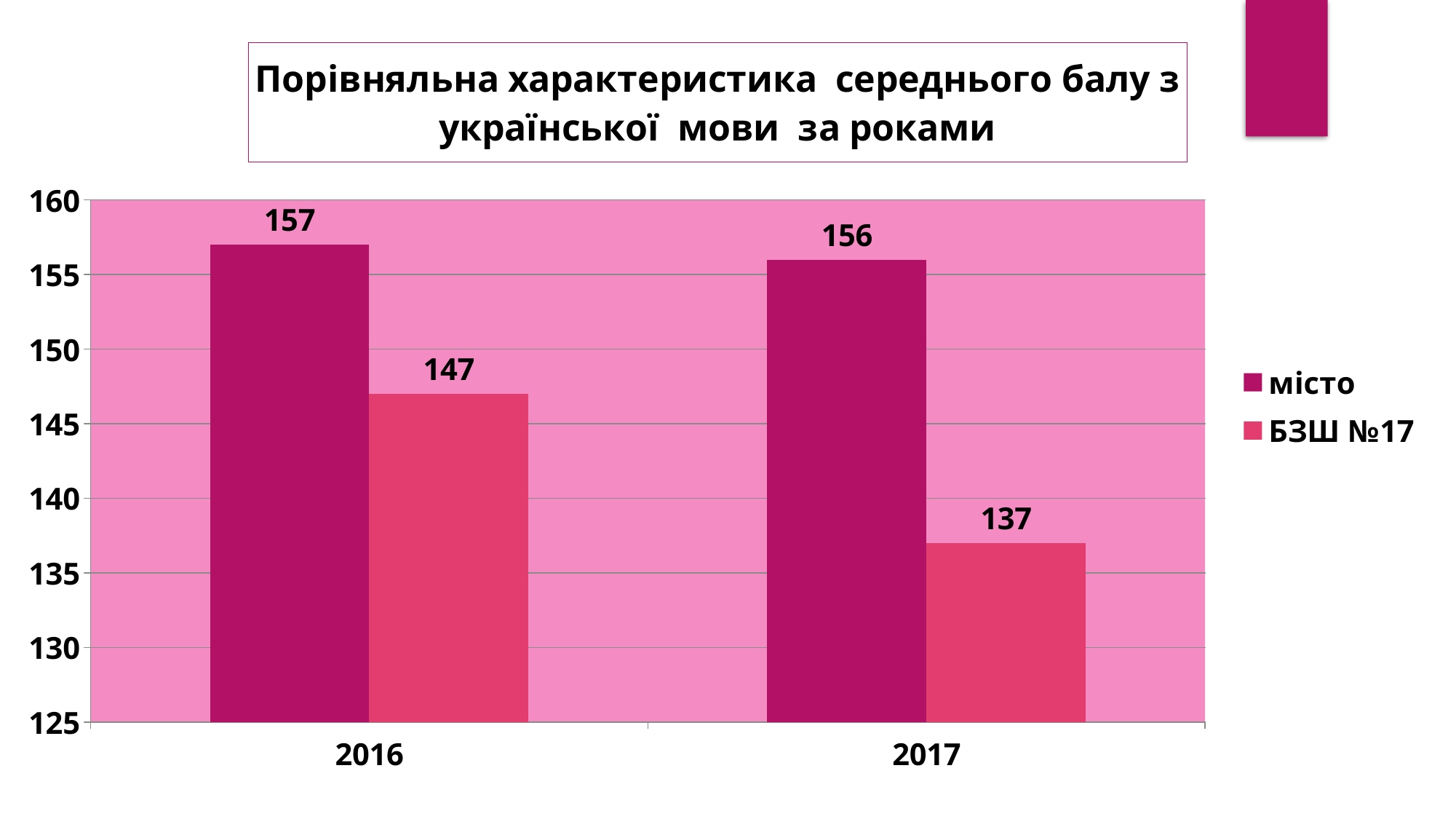
What is the value for БЗШ №17 in 2017? 137 What kind of chart is shown on the slide? bar chart Which is larger in 2016: місто or БЗШ №17? місто What is the difference between місто and БЗШ №17 in 2017? 19 What is the difference between the БЗШ №17 values for 2016 and 2017? 10 What is the value for місто in 2017? 156 What is the value for місто in 2016? 157 How many series does the legend list? 2 How many years are shown on the x axis? 2 What is the value for БЗШ №17 in 2016? 147 Do the values for БЗШ №17 rise or fall from 2016 to 2017? fall Which year has the lowest value for БЗШ №17? 2017